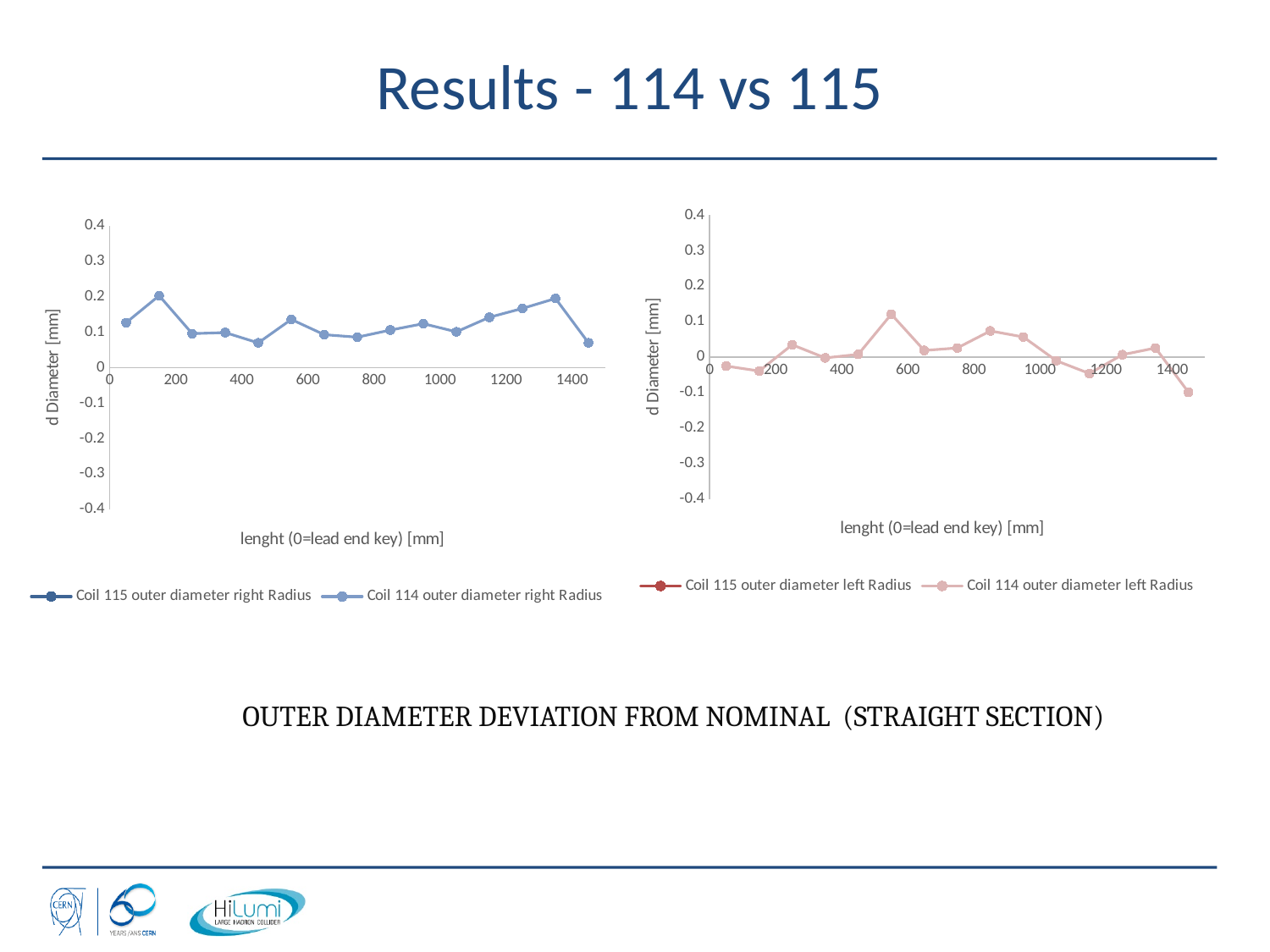
How many series does the legend of the right chart list? 2 In the right chart, does the Coil 114 outer diameter left Radius rise or fall between length 1350 mm and 1450 mm? fall In the left chart, is the Coil 114 outer diameter right Radius value at length 450 mm greater or less than 0.1? less In the right chart, is the Coil 114 outer diameter left Radius value at length 850 mm greater or less than 0.1? less What kind of chart is the right chart on the slide? line chart What kind of chart is the left chart on the slide? line chart What is the y-axis title of the left chart? d Diameter [mm] How many series does the legend of the left chart list? 2 What is the x-axis title of the right chart? lenght (0=lead end key) [mm] In the left chart, is the Coil 114 outer diameter right Radius value at length 1450 mm greater or less than 0.1? less